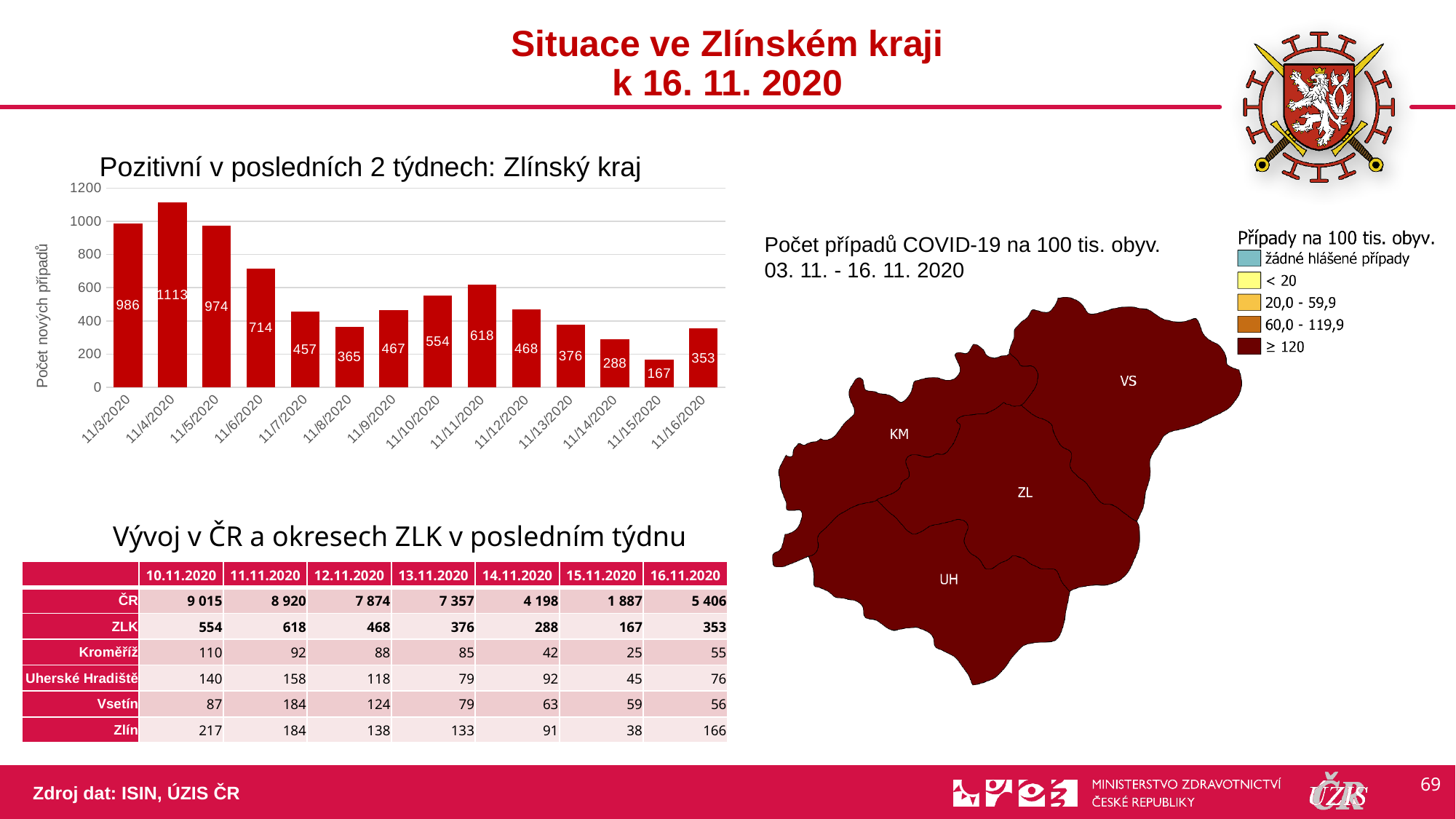
In the chart 'Pozitivní v posledních 2 týdnech: Zlínský kraj', what is the value for 11/16/2020? 353 In the chart 'Pozitivní v posledních 2 týdnech: Zlínský kraj', what is the value for 11/15/2020? 167 In the chart 'Pozitivní v posledních 2 týdnech: Zlínský kraj', which date has the highest value? 11/4/2020 In the chart 'Pozitivní v posledních 2 týdnech: Zlínský kraj', what is the difference between the values for 11/3/2020 and 11/6/2020? 272 In the chart 'Pozitivní v posledních 2 týdnech: Zlínský kraj', which is larger: the value for 11/6/2020 or 11/10/2020? 11/6/2020 What type of chart is 'Pozitivní v posledních 2 týdnech: Zlínský kraj'? bar chart In the chart 'Pozitivní v posledních 2 týdnech: Zlínský kraj', is the value for 11/3/2020 greater or less than 800? greater In the chart 'Pozitivní v posledních 2 týdnech: Zlínský kraj', what is the difference between the values for 11/11/2020 and 11/10/2020? 64 What is the y-axis title of the chart 'Pozitivní v posledních 2 týdnech: Zlínský kraj'? Počet nových případů In the chart 'Pozitivní v posledních 2 týdnech: Zlínský kraj', what is the value for 11/4/2020? 1113 How many dates (bars) are shown in the chart 'Pozitivní v posledních 2 týdnech: Zlínský kraj'? 14 In the chart 'Pozitivní v posledních 2 týdnech: Zlínský kraj', which date has the lowest value? 11/15/2020